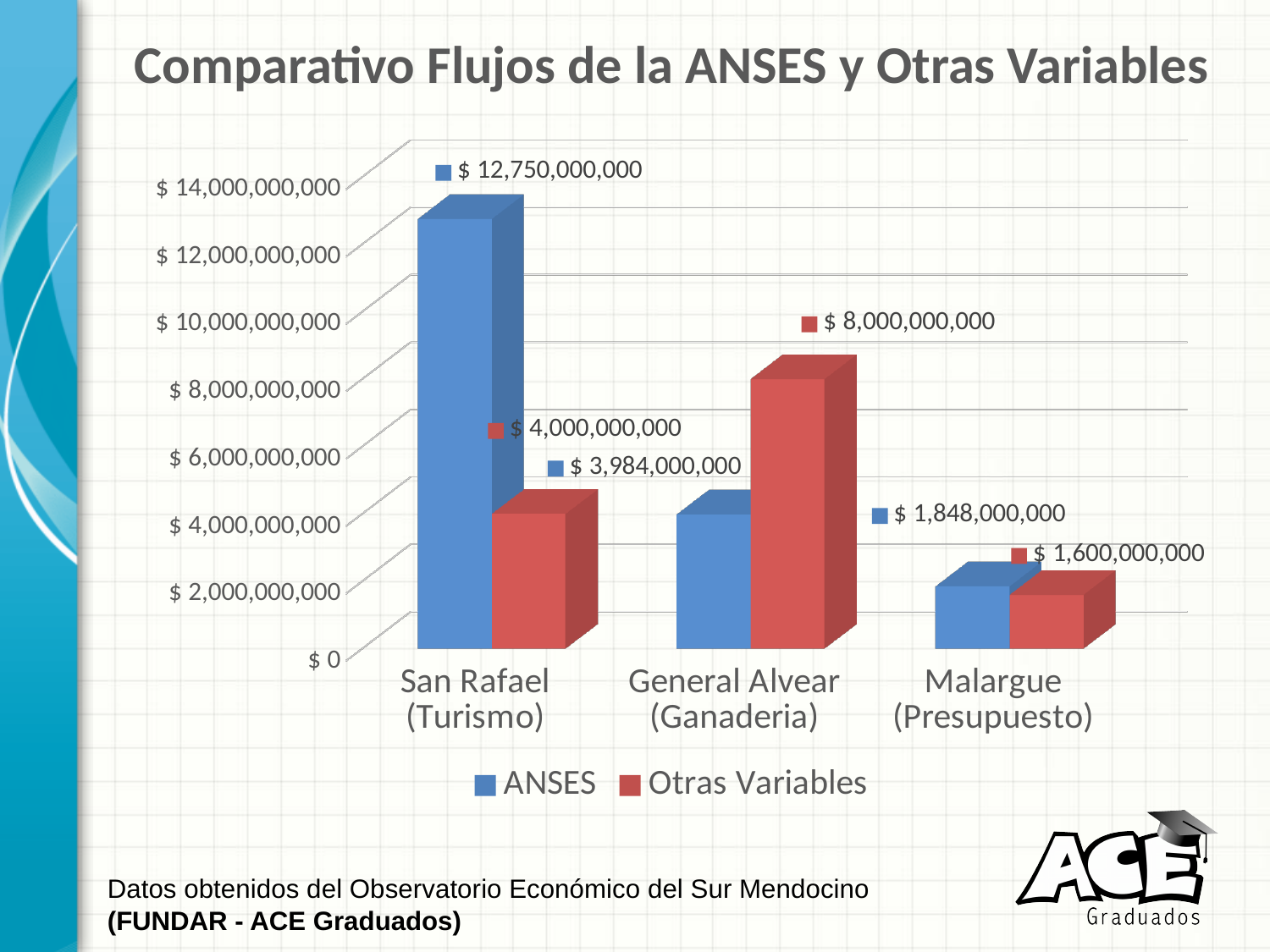
What is the difference between the Otras Variables and ANSES values for General Alvear (Ganaderia)? $ 4,016,000,000 How many categories are shown on the x axis? 3 What kind of chart is shown on the slide? Bar chart What is the Otras Variables value for General Alvear (Ganaderia)? $ 8,000,000,000 What is the ANSES value for San Rafael (Turismo)? $ 12,750,000,000 What is the ANSES value for Malargue (Presupuesto)? $ 1,848,000,000 For Malargue (Presupuesto), which is larger: the ANSES value or the Otras Variables value? ANSES What is the Otras Variables value for San Rafael (Turismo)? $ 4,000,000,000 Which category has the highest ANSES value? San Rafael (Turismo) How many series does the legend list? 2 What is the difference between the ANSES and Otras Variables values for San Rafael (Turismo)? $ 8,750,000,000 Which category has the lowest Otras Variables value? Malargue (Presupuesto)